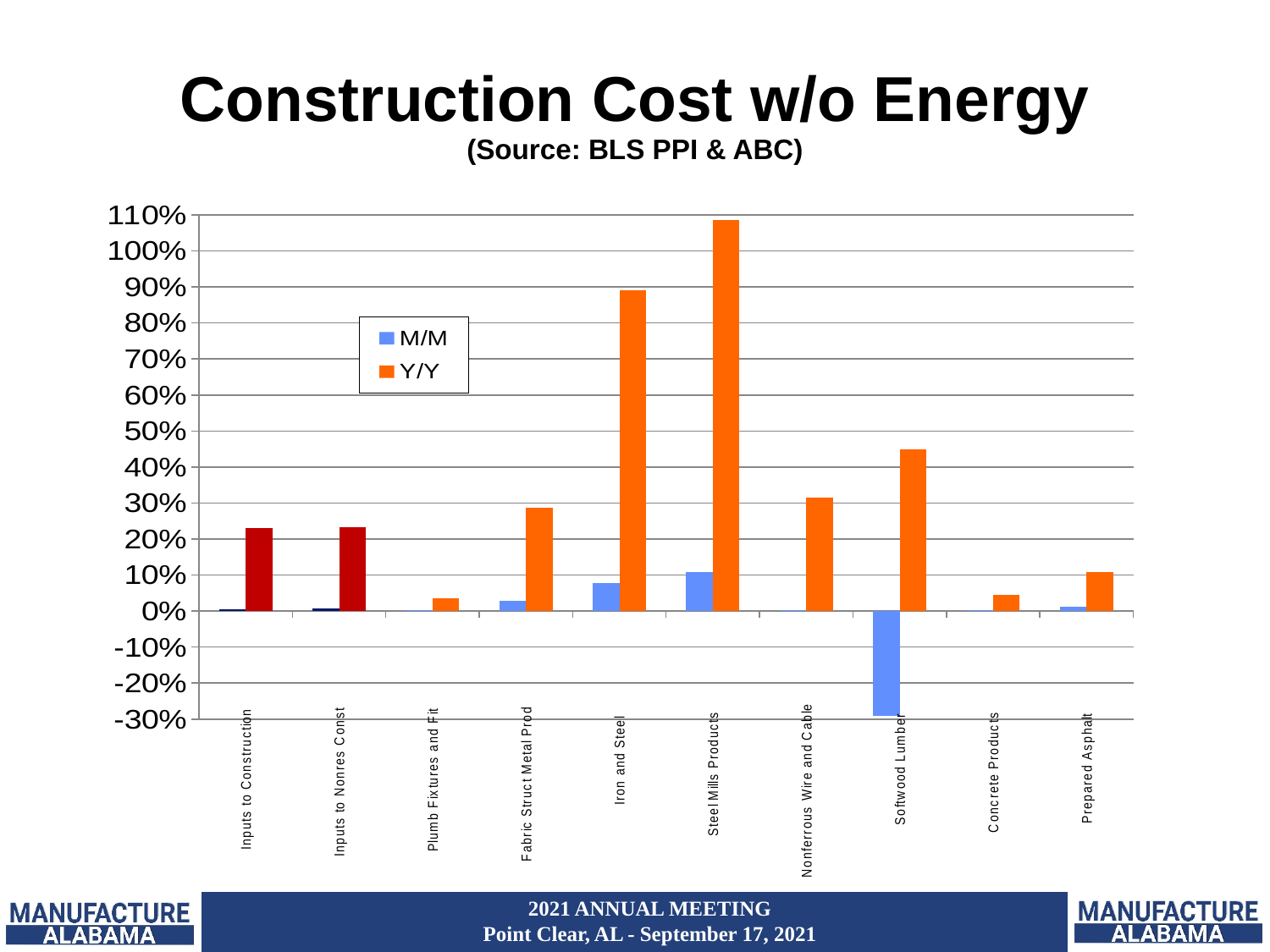
Is the Y/Y value for Softwood Lumber greater or less than 40%? greater Is the M/M value for Softwood Lumber greater or less than -20%? less Is the Y/Y value for Iron and Steel greater or less than 80%? greater Which category has the lowest M/M value? Softwood Lumber What is the title of the chart? Construction Cost w/o Energy How many categories are shown on the x axis? 10 Which has the larger M/M value, Iron and Steel or Steel Mills Products? Steel Mills Products How many series does the legend list? 2 Which has the larger Y/Y value, Iron and Steel or Softwood Lumber? Iron and Steel Which category has the highest Y/Y value? Steel Mills Products What kind of chart is shown on the slide? bar chart